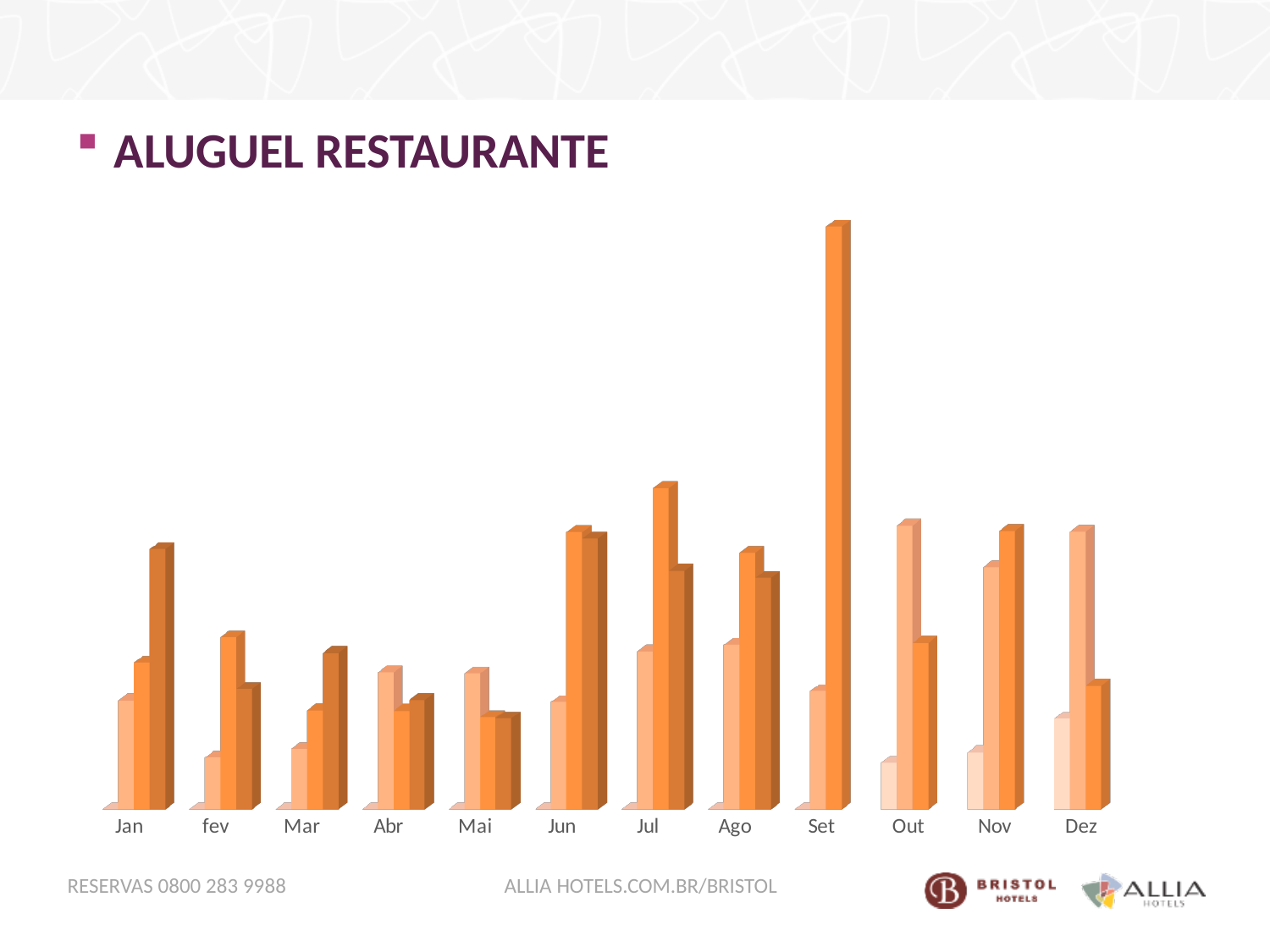
Which month's tallest bar is higher, Set or Jan? Set What is the first month label on the x axis? Jan Which month's tallest bar is higher, Jan or fev? Jan Which month has the tallest bar in the chart? Set How many months are shown along the x axis of the chart? 12 Which month's tallest bar is higher, Jun or Mai? Jun What is the title of the chart on the slide? ALUGUEL RESTAURANTE What kind of chart is shown on the slide? bar chart